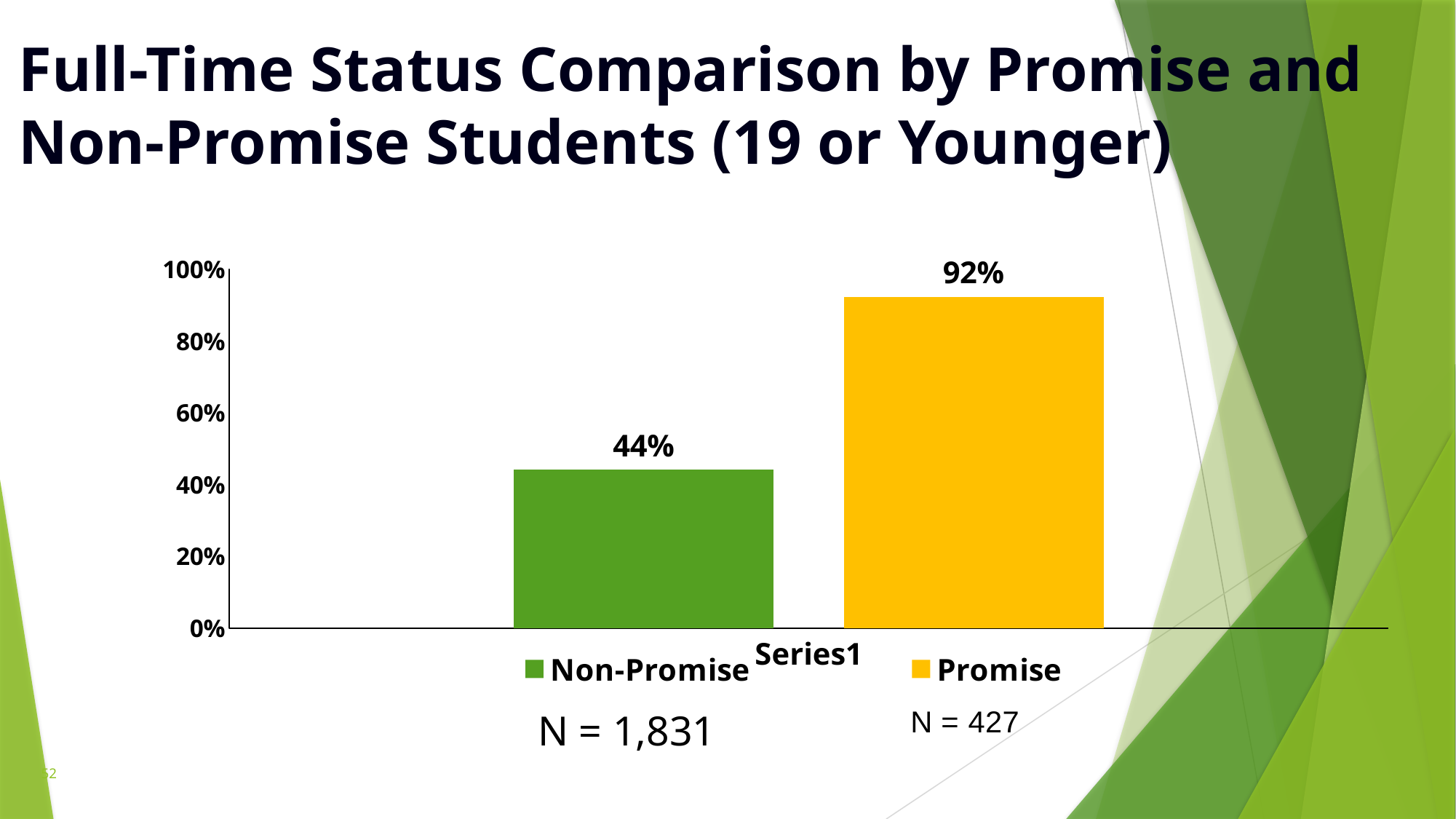
What is the difference between the Promise and Non-Promise values? 48% What colour is the Promise bar? yellow How many series does the legend list? 2 What is the sample size (N) shown for Non-Promise students? N = 1,831 What is the value for Promise students? 92% Is the value for Promise greater or less than 80%? greater What kind of chart is shown on the slide? bar chart What is the highest value shown on the vertical axis? 100% Which series has the higher value, Non-Promise or Promise? Promise What is the value for Non-Promise students? 44% Which series has the lower value? Non-Promise Is the value for Non-Promise greater or less than 60%? less